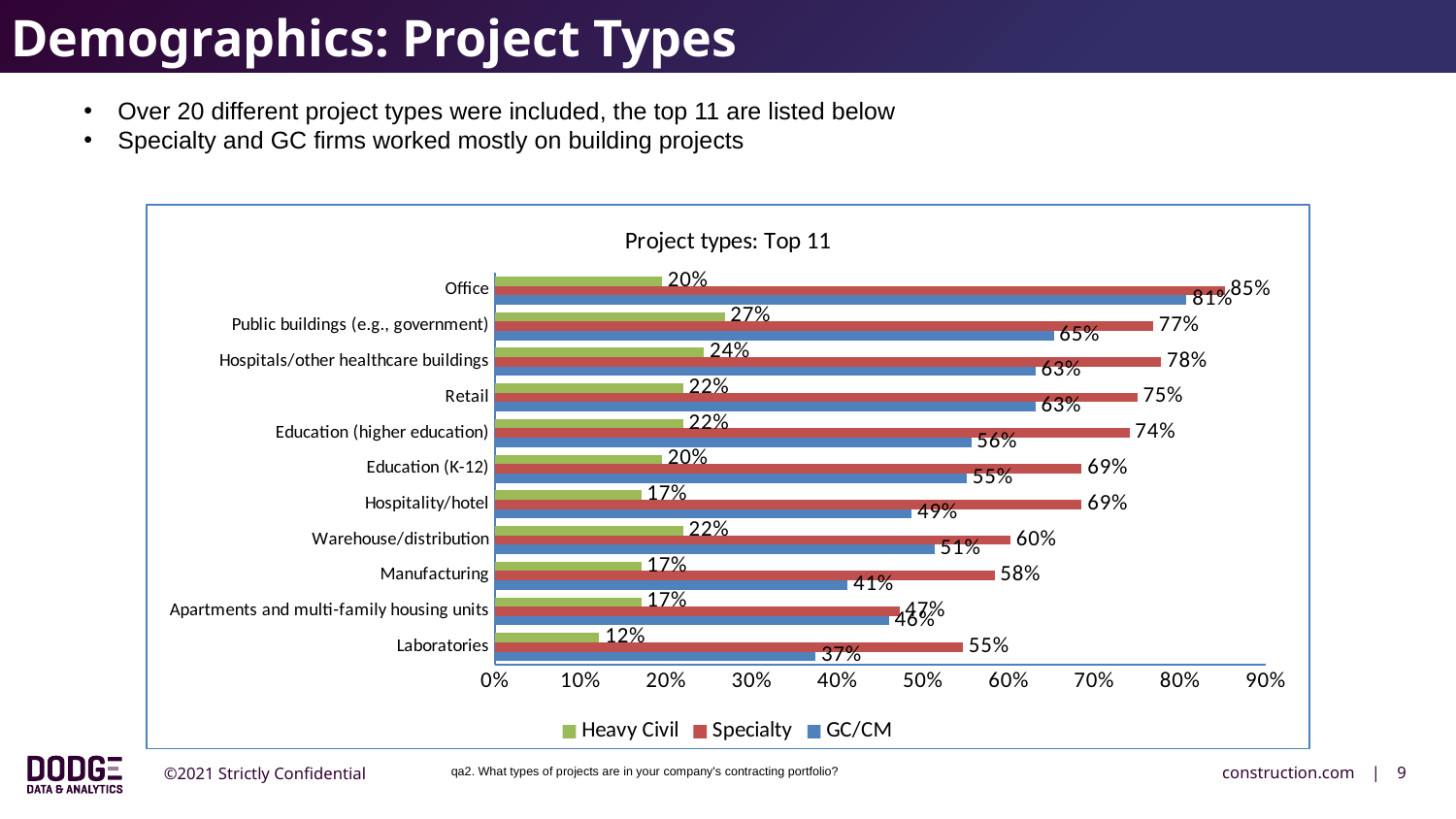
What is the title of the chart? Project types: Top 11 What is the GC/CM value for Hospitals/other healthcare buildings? 63% Which project type has the highest GC/CM value? Office What is the Specialty value for Office? 85% How many series does the legend list? 3 What type of chart is shown on the slide? Bar chart What is the GC/CM value for Laboratories? 37% What is the difference between the Specialty and GC/CM values for Manufacturing? 17% Which is larger for Warehouse/distribution: the Specialty value or the GC/CM value? Specialty What is the Heavy Civil value for Public buildings (e.g., government)? 27% Which project type has the lowest Heavy Civil value? Laboratories How many project types are shown in the chart? 11